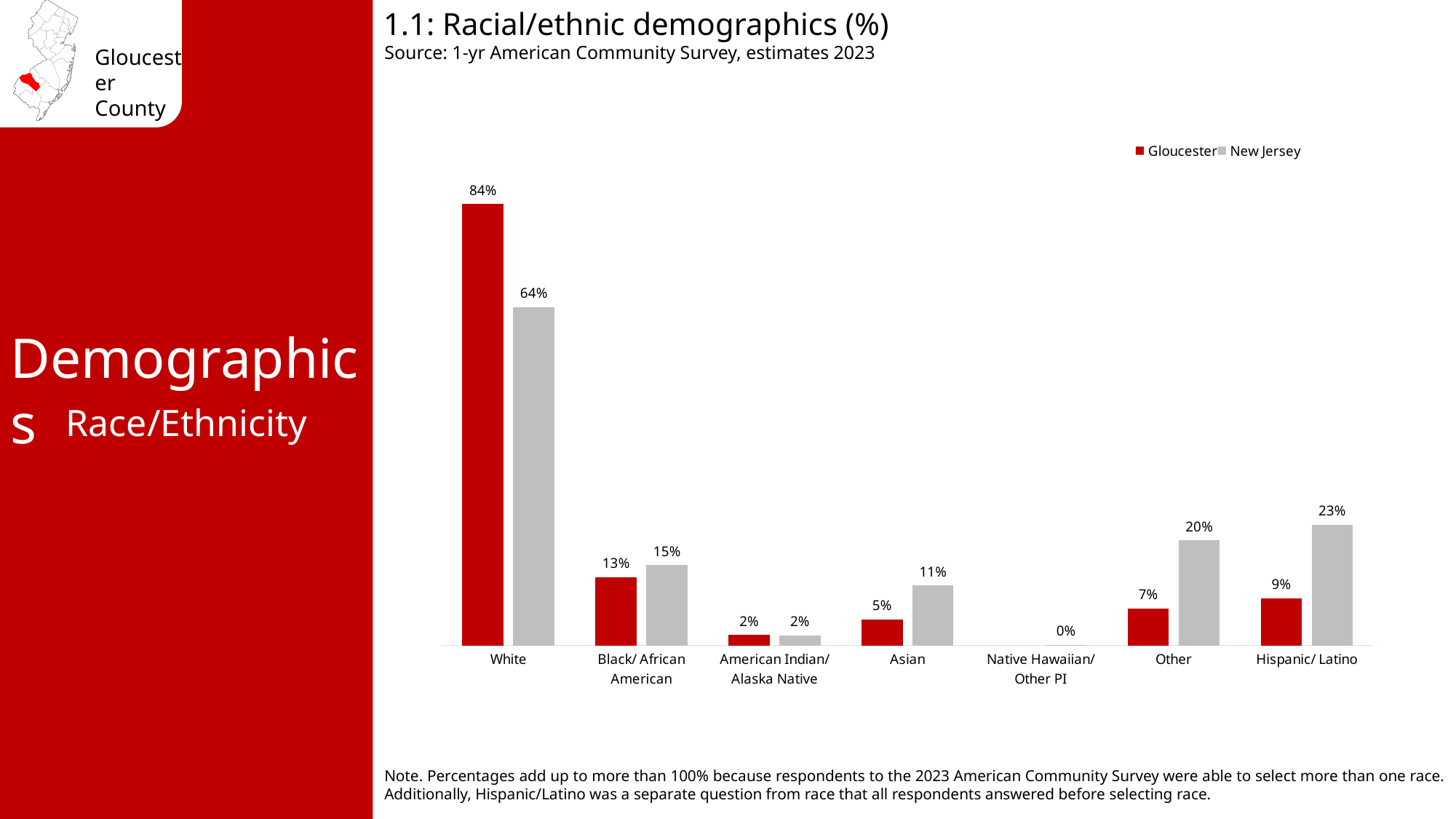
How many series does the legend list? 2 For Asian, which is larger: the Gloucester value or the New Jersey value? New Jersey How many racial/ethnic categories are shown on the x axis? 7 What is the New Jersey value for Hispanic/ Latino? 23% Which category has the lowest New Jersey value? Native Hawaiian/ Other PI What is the difference between the Gloucester and New Jersey values for White? 20 percentage points What kind of chart is shown on the slide? Bar chart What is the New Jersey value for Other? 20% What is the Gloucester value for Asian? 5% Which category has the highest Gloucester value? White What is the Gloucester value for White? 84% What colour represents Gloucester in the legend? Red